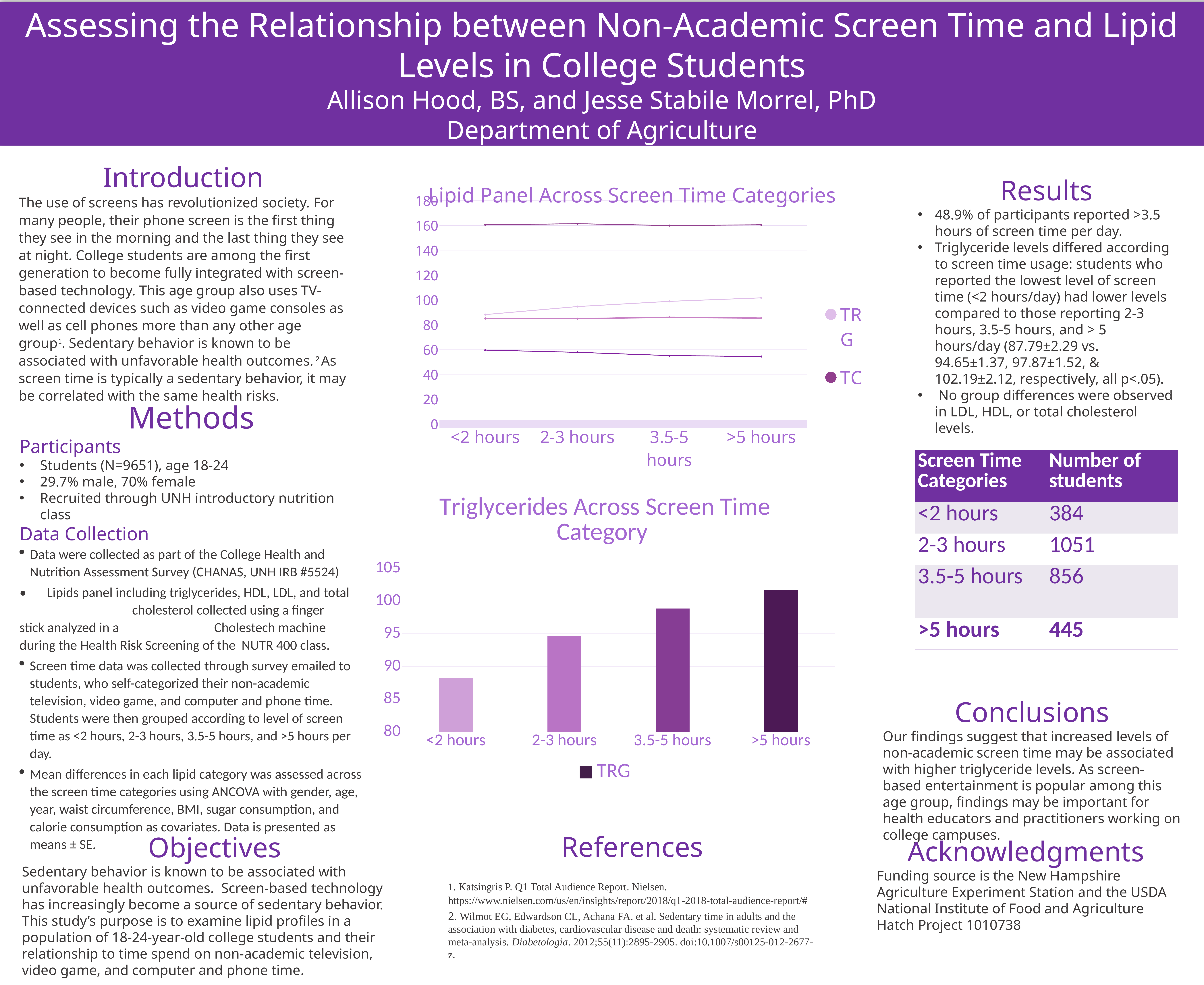
In the 'Triglycerides Across Screen Time Category' chart, which screen time category has the lowest triglyceride value? <2 hours In the 'Triglycerides Across Screen Time Category' chart, is the value for >5 hours greater or less than 100? greater In the 'Triglycerides Across Screen Time Category' chart, is the value for <2 hours greater or less than 90? less What kind of chart is the 'Lipid Panel Across Screen Time Categories' chart? line chart In the 'Lipid Panel Across Screen Time Categories' chart, is the TC value for <2 hours greater or less than 140? greater In the 'Triglycerides Across Screen Time Category' chart, which is larger, the value for 2-3 hours or the value for 3.5-5 hours? 3.5-5 hours In the 'Triglycerides Across Screen Time Category' chart, do the values rise or fall as screen time increases along the x axis? rise In the 'Triglycerides Across Screen Time Category' chart, which screen time category has the highest triglyceride value? >5 hours What series name is listed in the legend of the 'Triglycerides Across Screen Time Category' chart? TRG In the 'Triglycerides Across Screen Time Category' chart, how many screen time categories are shown on the x axis? 4 What kind of chart is the 'Triglycerides Across Screen Time Category' chart? bar chart In the 'Lipid Panel Across Screen Time Categories' chart, does the TRG line rise or fall from <2 hours to >5 hours? rise